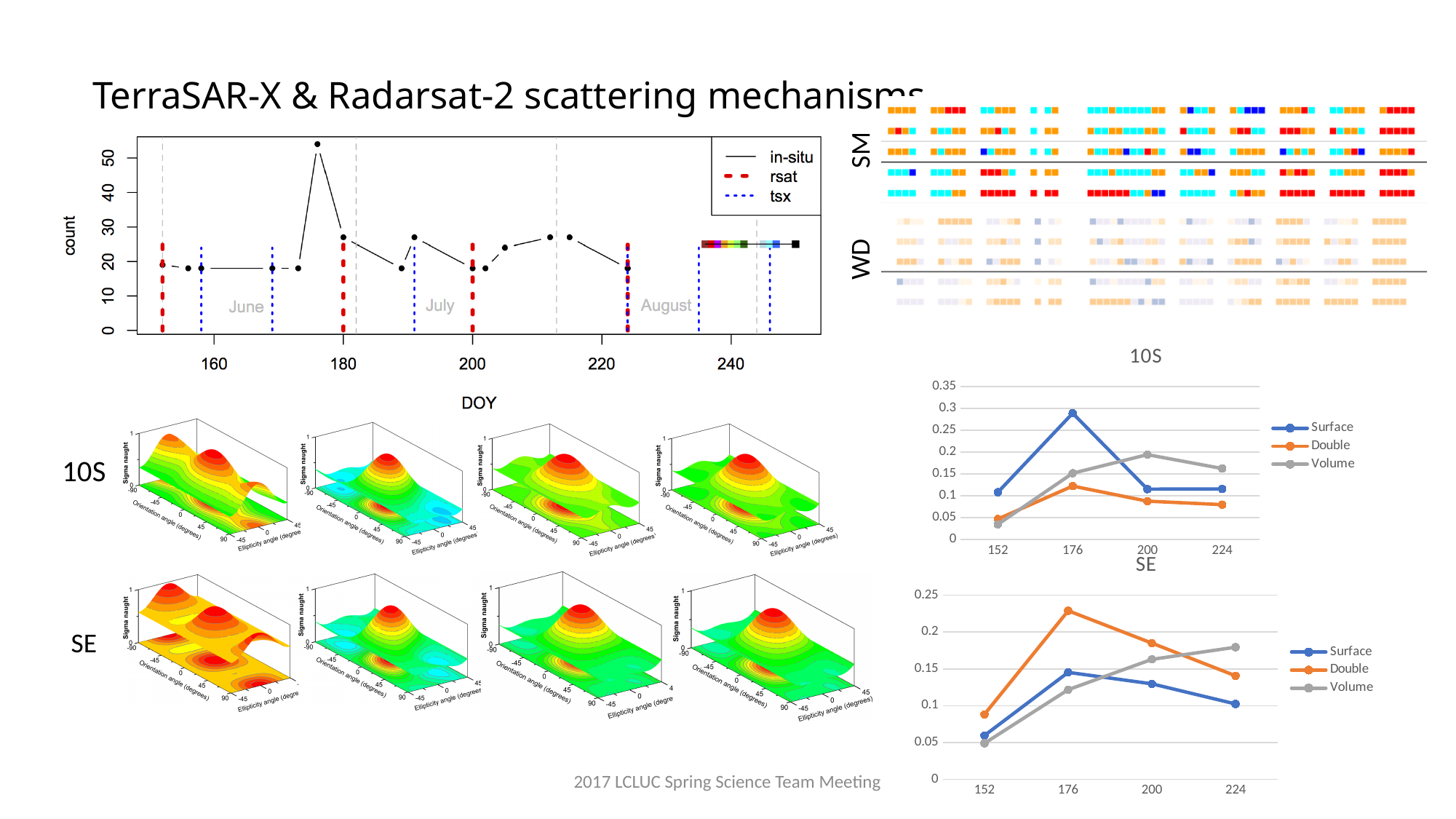
On the 10S chart, is the Volume value at 200 greater or less than 0.15? greater On the 10S chart, which series has the highest value at 176? Surface On the 10S chart, is the Surface value at 176 greater or less than 0.25? greater What kind of chart is the 10S chart on the right of the slide? line chart On the SE chart, at 224, which is larger: Volume or Surface? Volume On the 10S line chart, how many series does the legend list? 3 On the SE chart, does the Volume series rise or fall from 152 to 224? rises On the SE line chart, which series has the highest value at 176? Double On the top-left count chart, what is the x-axis label? DOY On the SE chart, is the Double value at 176 greater or less than 0.2? greater On the 10S chart, how many x-axis points are plotted for each series? 4 On the 10S chart, at 224, which is larger: Volume or Double? Volume